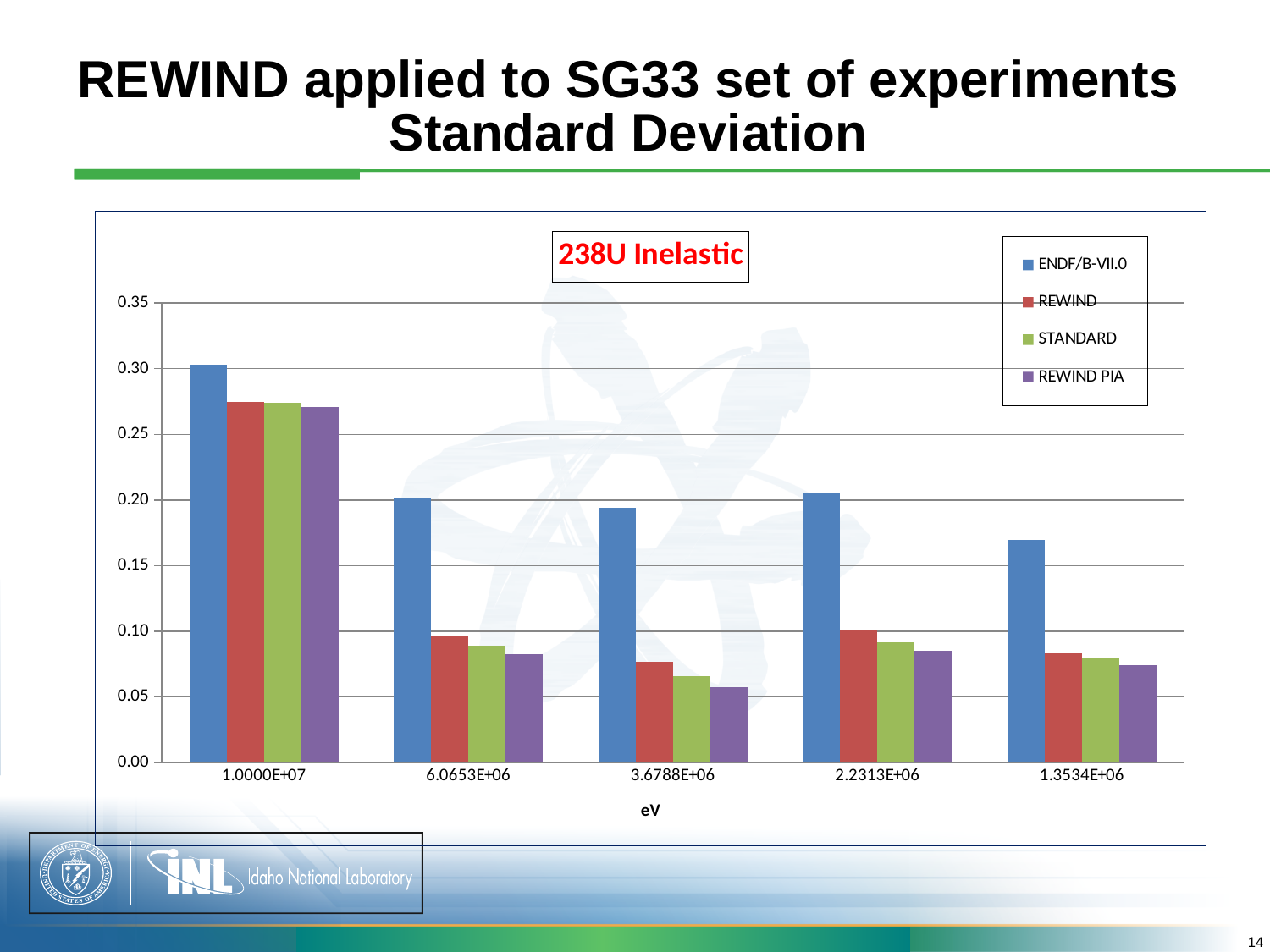
What is the title shown inside the chart? 238U Inelastic How many series does the legend list? 4 What is the label of the x axis? eV For which energy category is the ENDF/B-VII.0 value highest? 1.0000E+07 Which series has the highest value at 3.6788E+06? ENDF/B-VII.0 What kind of chart is shown on the slide? bar chart At 6.0653E+06, which is larger: the ENDF/B-VII.0 value or the REWIND value? ENDF/B-VII.0 Is the STANDARD value at 3.6788E+06 greater or less than 0.10? less For which energy category is the ENDF/B-VII.0 value lowest? 1.3534E+06 How many energy categories are shown on the x axis? 5 Is the ENDF/B-VII.0 value at 1.0000E+07 greater or less than 0.25? greater Which series has the lowest value at 3.6788E+06? REWIND PIA